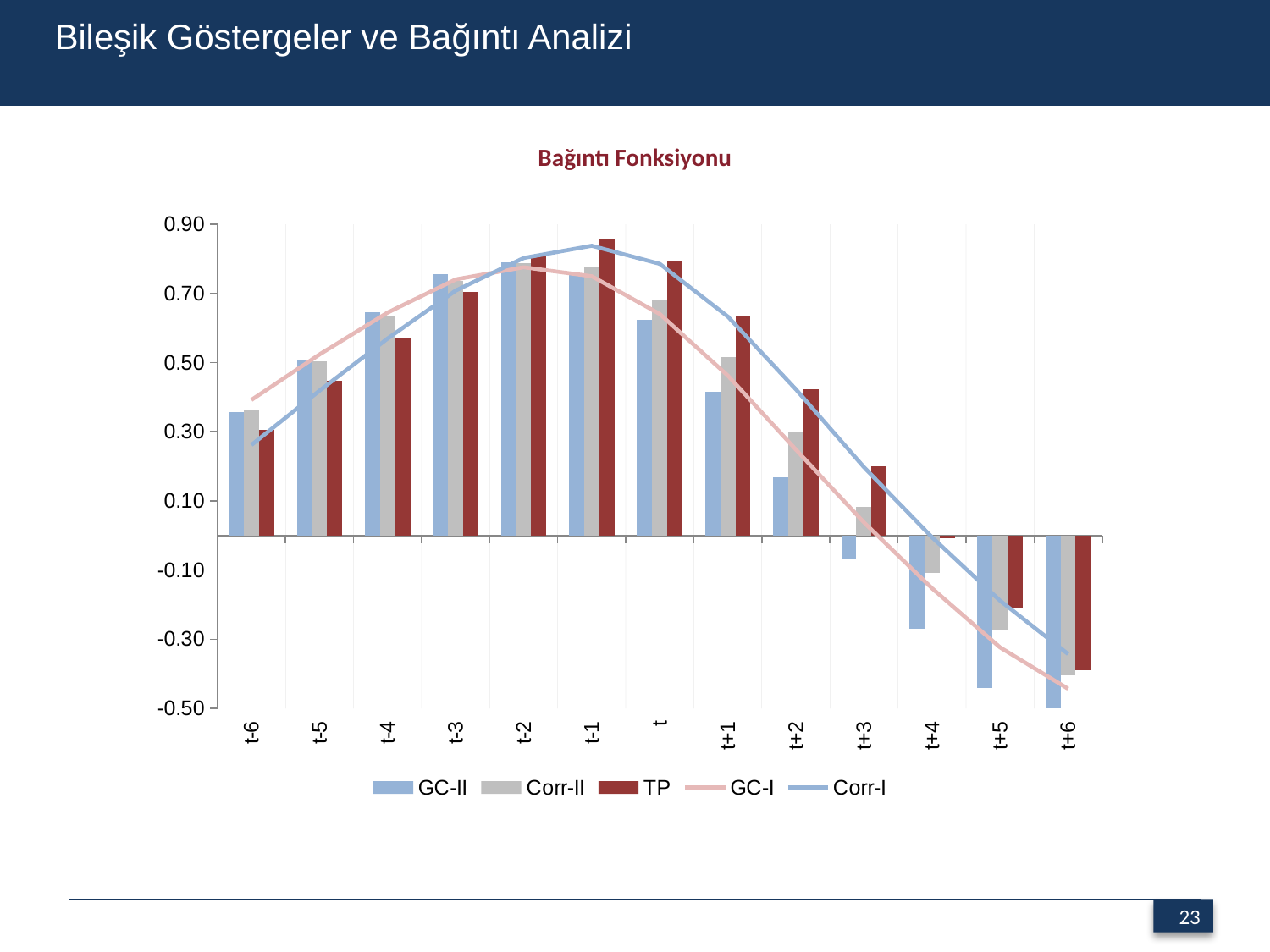
What kind of chart is shown on the slide? A combined bar and line chart At t-6, which is larger: the GC-II bar or the TP bar? GC-II How many series does the chart legend list? 5 Do the GC-II values rise or fall from t+1 to t+6? fall At which category does the GC-II series reach its lowest value? t+6 At which category does the TP series reach its highest value? t-1 Is the GC-II value at t+6 greater or less than -0.30? less Is the TP value at t+3 greater or less than 0.10? greater What is the title of the chart? Bağıntı Fonksiyonu Is the TP value at t-1 greater or less than 0.70? greater How many categories are shown on the x axis of the chart? 13 At t+1, which is larger: the TP bar or the GC-II bar? TP